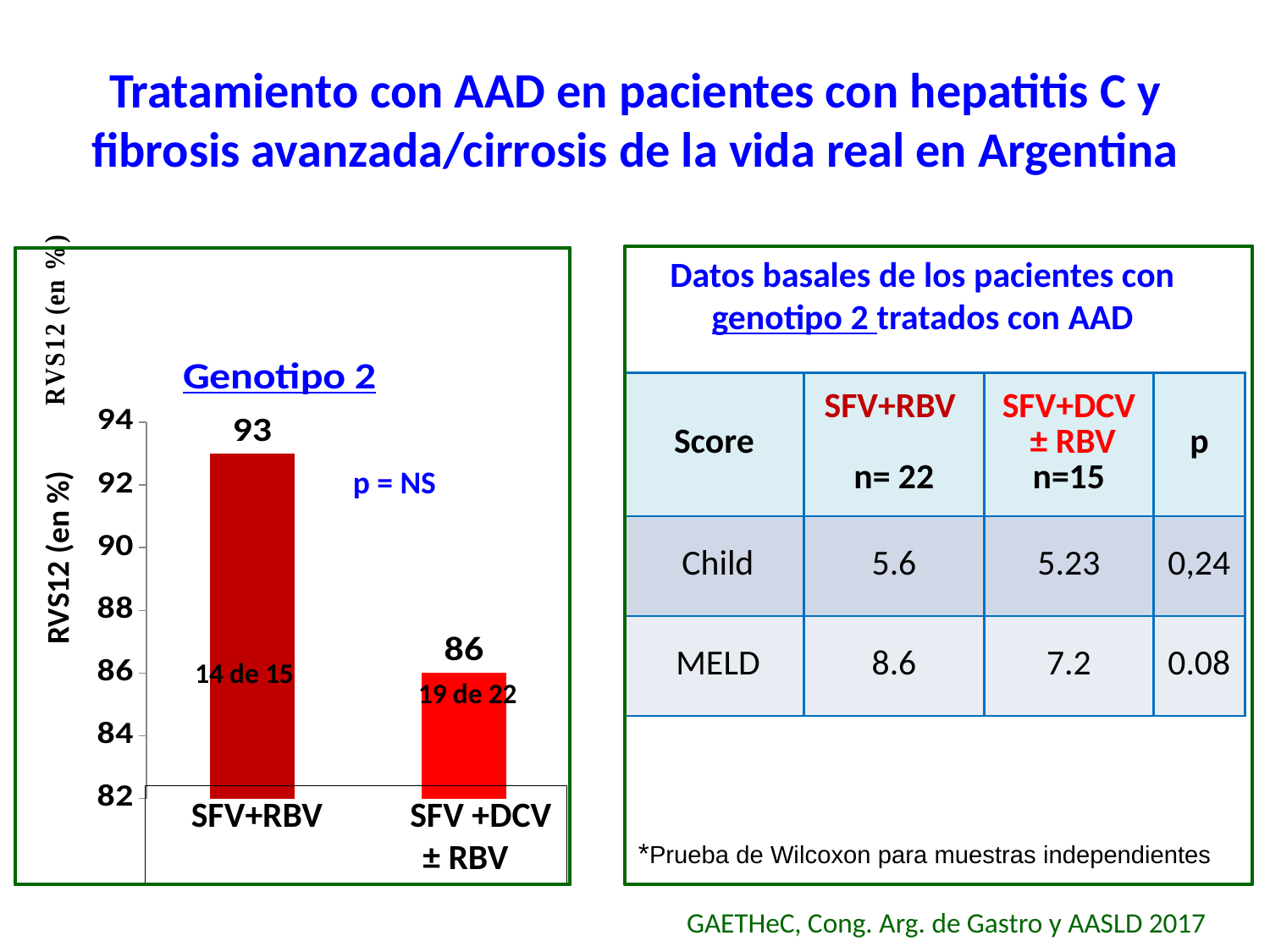
What is the label of the y axis in the Genotipo 2 chart? RVS12 (en %) What is the RVS12 value for SFV +DCV ± RBV in the Genotipo 2 chart? 86 Which treatment has the higher RVS12 value in the Genotipo 2 chart? SFV+RBV What is the RVS12 value for SFV+RBV in the Genotipo 2 chart? 93 What is the title of the chart on the left of the slide? Genotipo 2 How many treatment categories are shown in the Genotipo 2 chart? 2 Is the RVS12 value for SFV +DCV ± RBV greater or less than 88? less Is the RVS12 value for SFV+RBV greater or less than 90? greater What is the difference in RVS12 between SFV+RBV and SFV +DCV ± RBV in the Genotipo 2 chart? 7 What patient count label is printed on the SFV+RBV bar in the Genotipo 2 chart? 14 de 15 Which treatment has the lower RVS12 value in the Genotipo 2 chart? SFV +DCV ± RBV What type of chart is used to show the RVS12 results for Genotipo 2? Bar chart